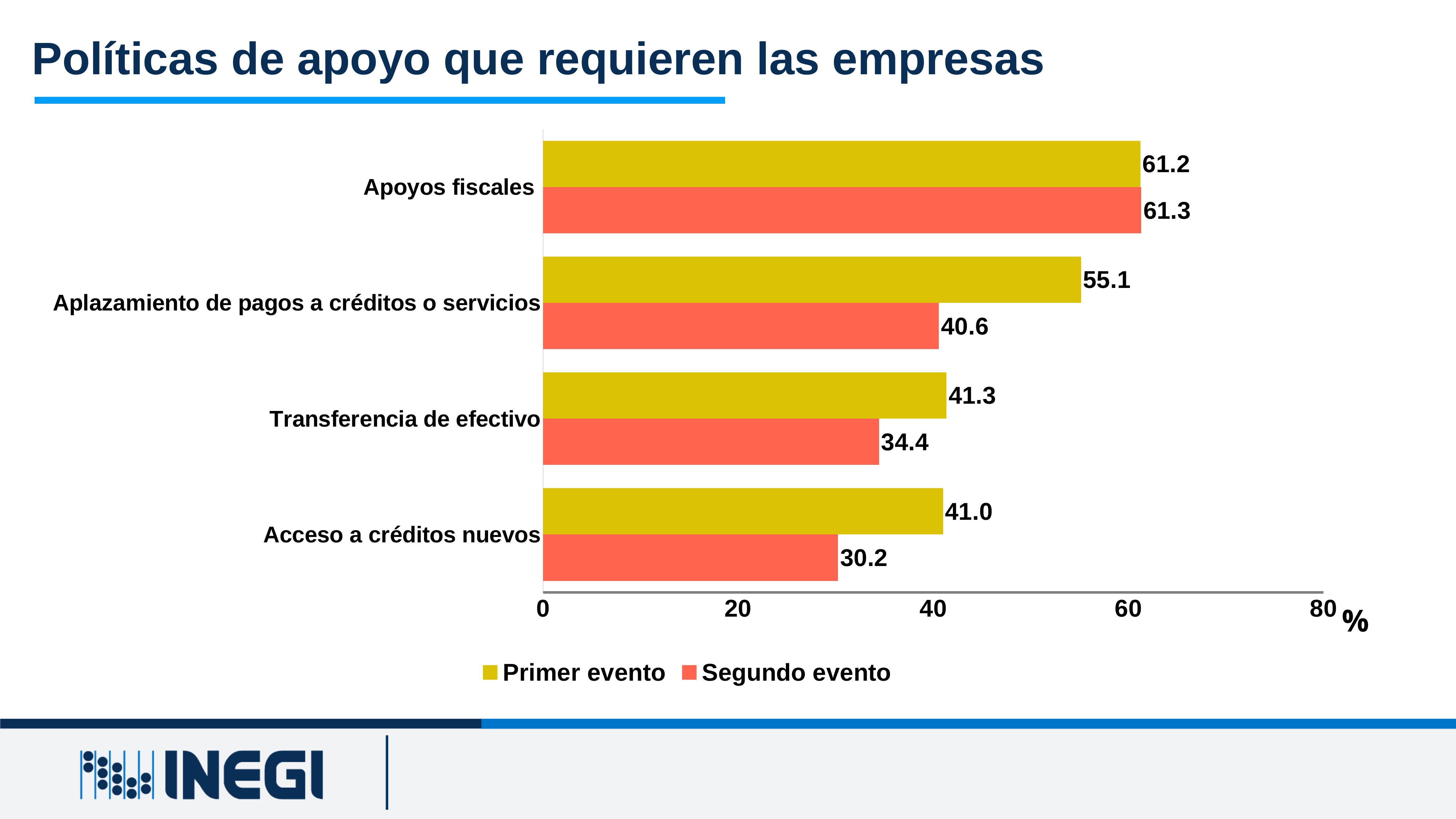
What kind of chart is shown on the slide? Bar chart What is the value for Aplazamiento de pagos a créditos o servicios in the Segundo evento series? 40.6 Which category has the lowest value in the Primer evento series? Acceso a créditos nuevos What colour represents the Segundo evento series? Red (salmon) What is the value for Acceso a créditos nuevos in the Segundo evento series? 30.2 What is the value for Transferencia de efectivo in the Primer evento series? 41.3 How many series does the legend list? 2 What is the value for Apoyos fiscales in the Primer evento series? 61.2 What is the difference between the Primer evento and Segundo evento values for Aplazamiento de pagos a créditos o servicios? 14.5 Which category has the highest value in the Segundo evento series? Apoyos fiscales How many categories are shown on the chart? 4 Which is larger for Transferencia de efectivo: the Primer evento value or the Segundo evento value? Primer evento